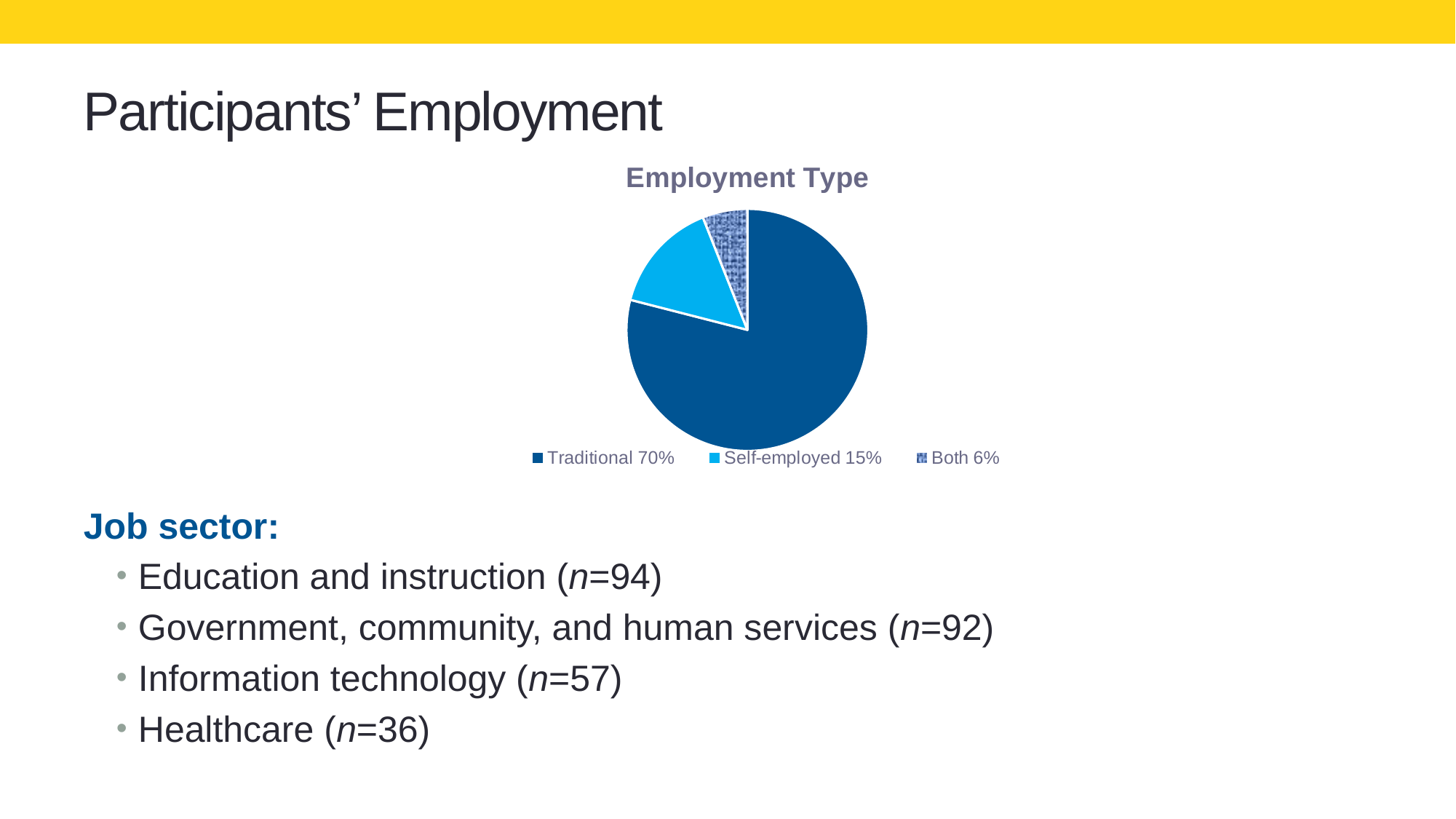
Which employment type has the largest slice? Traditional What share of the pie is Traditional? 70% Which employment type has the smallest slice? Both What is the difference in percentage points between Traditional and Self-employed? 55 Which is larger, the Self-employed slice or the Both slice? Self-employed What share of the pie is Self-employed? 15% What is the title of the chart? Employment Type How many slices does the pie chart have? 3 What share of the pie is Both? 6% What is the difference in percentage points between Self-employed and Both? 9 Which slice is shown with a patterned fill in the legend? Both What type of chart is shown on the slide? pie chart